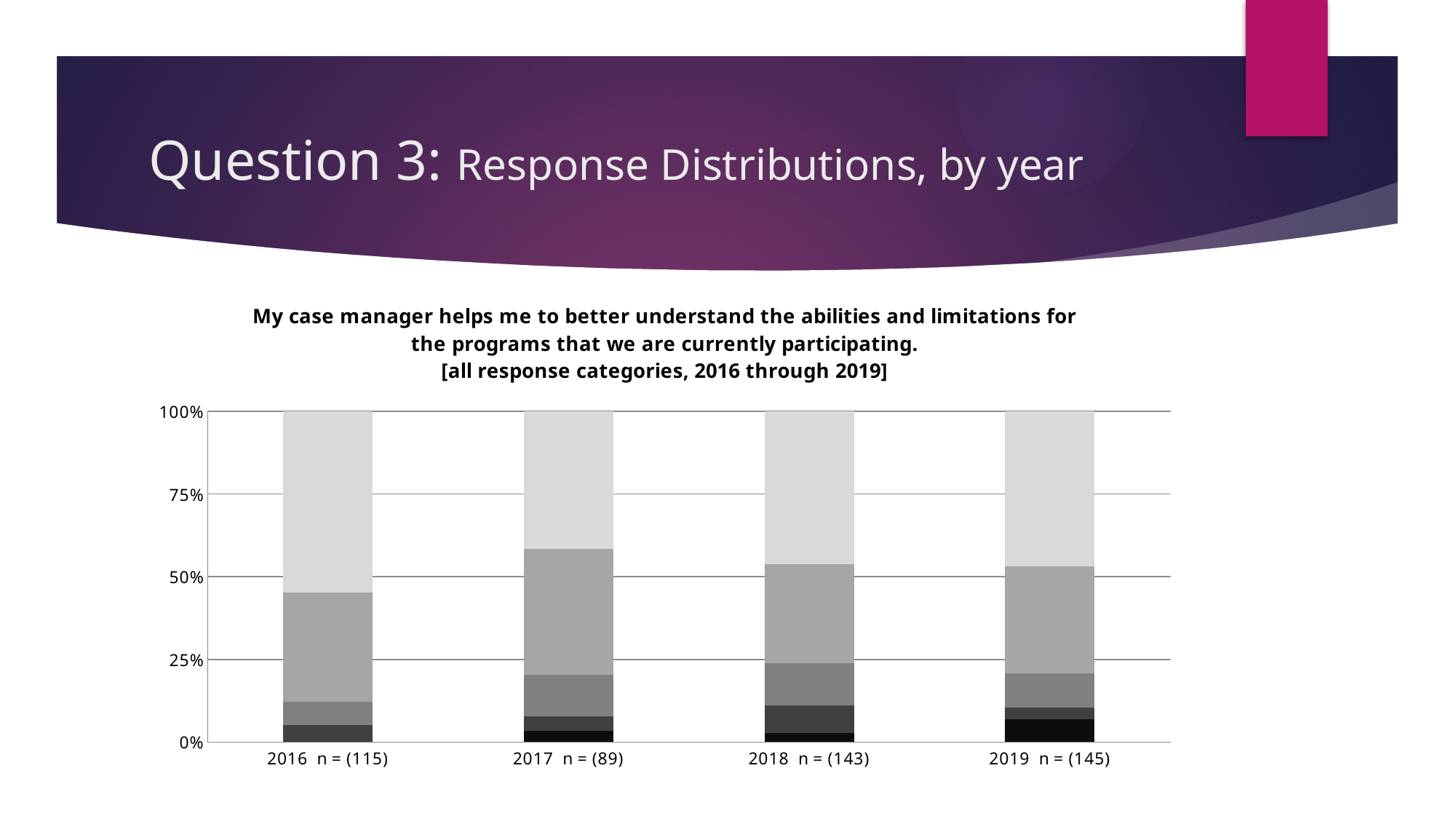
Which year has the largest lightest-grey (top) segment? 2016 In 2017, is the combined height of the segments below the lightest-grey top segment greater or less than 50%? greater In 2016, is the combined height of the segments below the lightest-grey top segment greater or less than 50%? less Which year has the smallest lightest-grey (top) segment? 2017 What is the sample size (n) shown for 2018? 143 Which year range does the chart title say the response categories cover? 2016 through 2019 What is the sample size (n) shown for 2017? 89 What is the sample size (n) shown for 2016? 115 How many years (bars) are shown on the x axis? 4 What kind of chart is shown on the slide? Stacked bar chart What is the sample size (n) shown for 2019? 145 What is the total height of each stacked bar? 100%